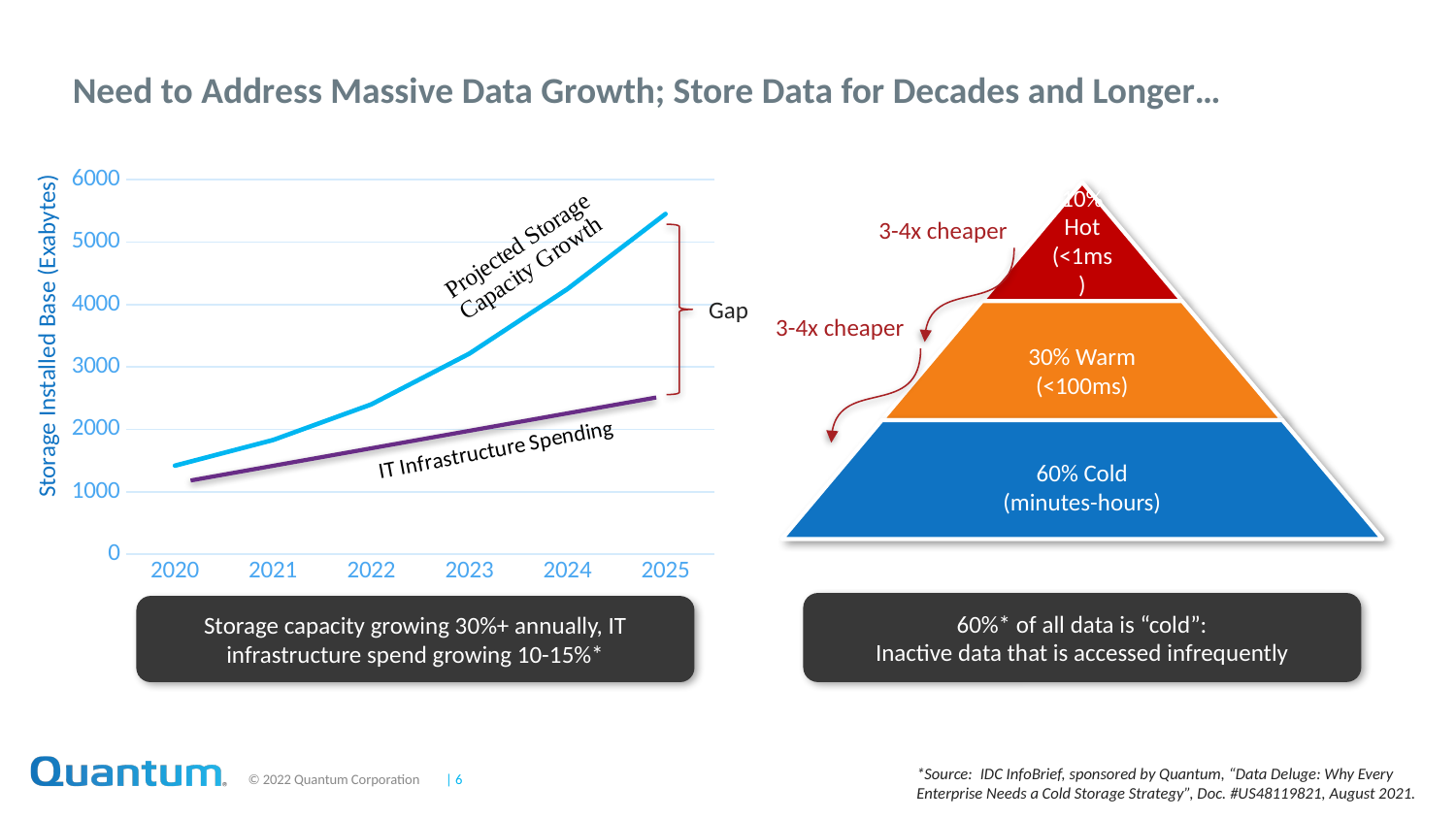
In the line chart, is the Projected Storage Capacity Growth value for 2020 greater or less than 2000? less In the line chart, is the Projected Storage Capacity Growth value for 2022 greater or less than 3000? less How many years are shown on the x axis of the line chart? 6 In the line chart, is the IT Infrastructure Spending value for 2025 greater or less than 3000? less What kind of chart is shown on the left of the slide? line chart What is the y-axis label of the line chart? Storage Installed Base (Exabytes) In the line chart, which series has the higher value in 2025, Projected Storage Capacity Growth or IT Infrastructure Spending? Projected Storage Capacity Growth In the line chart, does the Projected Storage Capacity Growth line rise or fall from 2020 to 2025? rise How many data series are plotted in the line chart? 2 In the line chart, in which year is the Projected Storage Capacity Growth value highest? 2025 In the line chart, does the IT Infrastructure Spending line rise or fall from 2020 to 2025? rise